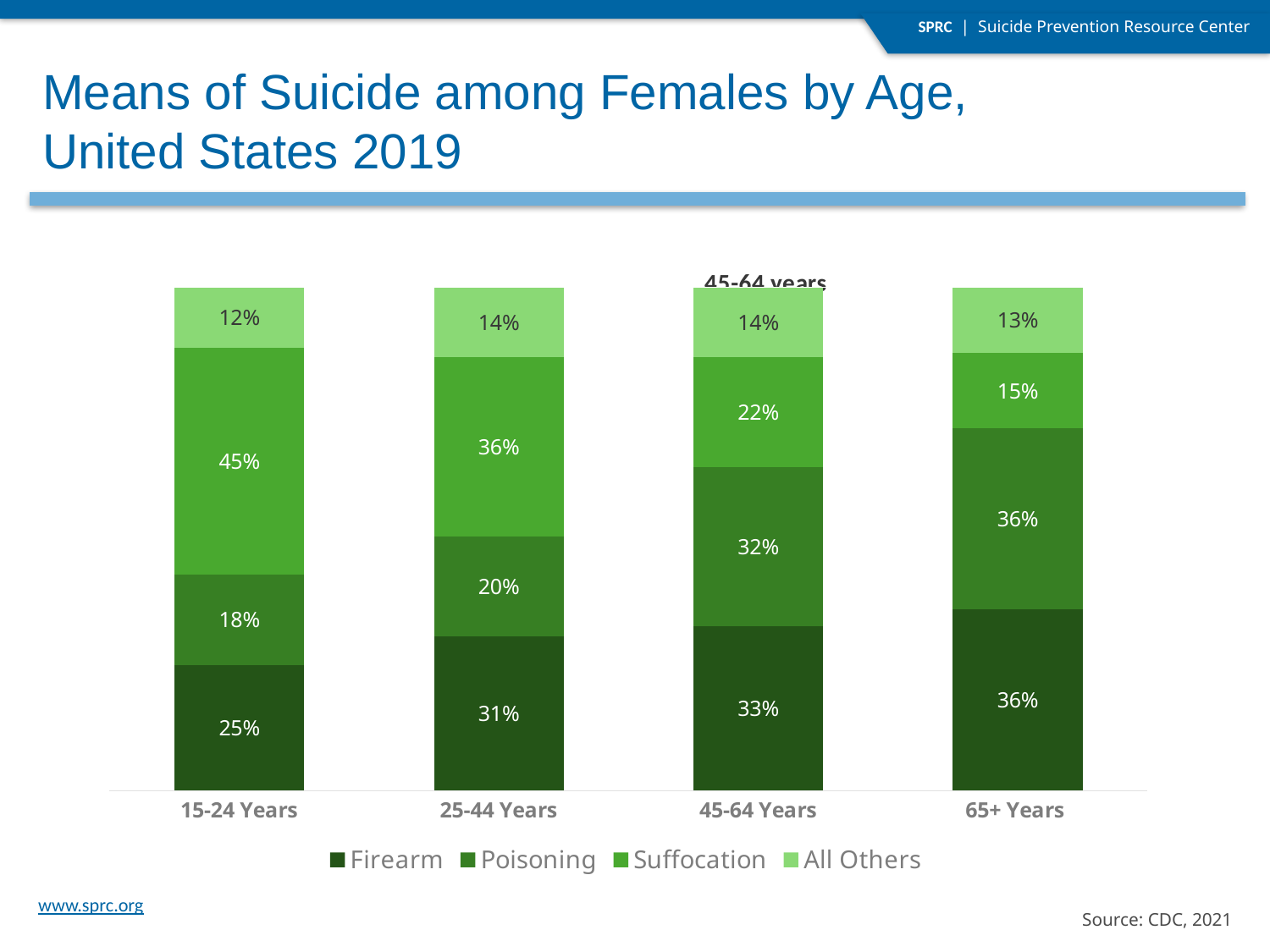
What is the Suffocation share for the 25-44 Years group? 36% What is the Firearm share for the 15-24 Years group? 25% Does the Firearm share rise or fall as age increases from 15-24 Years to 65+ Years? Rise Which age group has the highest Suffocation share? 15-24 Years What is the Poisoning share for the 45-64 Years group? 32% What is the difference between the Firearm share for 65+ Years and the Firearm share for 15-24 Years? 11% How many series does the legend list? 4 What is the All Others share for the 65+ Years group? 13% How many age groups are shown on the x axis? 4 Which age group has the lowest Firearm share? 15-24 Years Which is larger for the 45-64 Years group, the Firearm share or the Suffocation share? Firearm What kind of chart is shown on the slide? Stacked bar chart